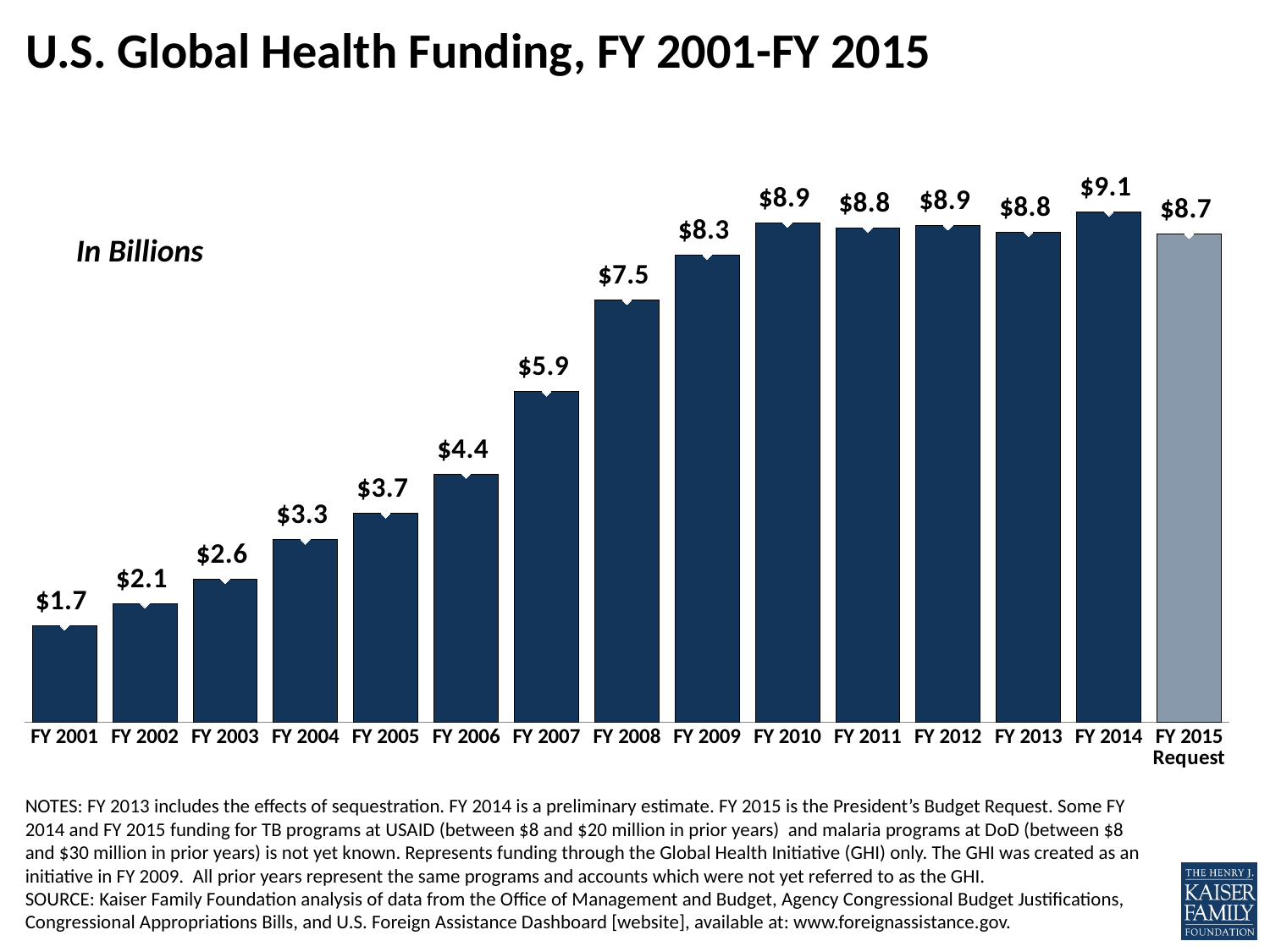
What is the U.S. global health funding value for FY 2001? $1.7 What is the difference between the FY 2009 value and the FY 2008 value? $0.8 What is the funding value shown for FY 2008? $7.5 Which fiscal year has the lowest funding value? FY 2001 What is the title of the chart? U.S. Global Health Funding, FY 2001-FY 2015 Which fiscal year has the highest funding value? FY 2014 How many fiscal years (bars) are shown in the chart? 15 Do the funding values generally rise or fall from FY 2001 to FY 2010? Rise What kind of chart is shown on the slide? Bar chart What is the difference between the FY 2014 value and the FY 2001 value? $7.4 What is the funding value shown for the FY 2015 Request? $8.7 Which is larger, the value for FY 2007 or the value for FY 2006? FY 2007